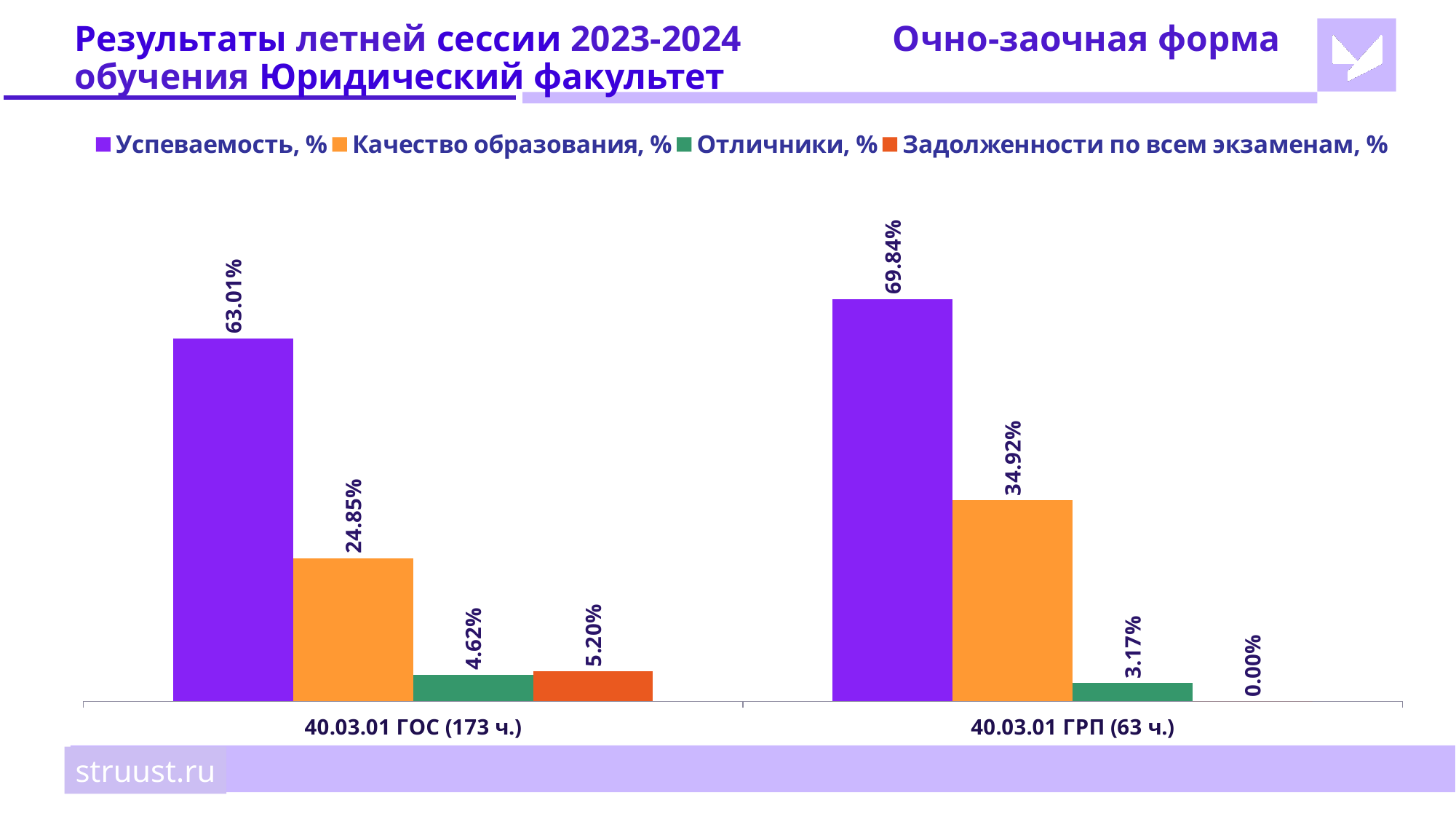
What is the difference in Успеваемость, % between 40.03.01 ГРП (63 ч.) and 40.03.01 ГОС (173 ч.)? 6.83% What is the difference in Качество образования, % between 40.03.01 ГРП (63 ч.) and 40.03.01 ГОС (173 ч.)? 10.07% What is the value of Задолженности по всем экзаменам, % for 40.03.01 ГРП (63 ч.)? 0.00% How many series does the legend list? 4 What is the value of Качество образования, % for 40.03.01 ГРП (63 ч.)? 34.92% What kind of chart is shown on the slide? Bar chart Which category has the lower value for Качество образования, %? 40.03.01 ГОС (173 ч.) Which category has the higher value for Успеваемость, %? 40.03.01 ГРП (63 ч.) What is the value of Успеваемость, % for 40.03.01 ГОС (173 ч.)? 63.01% Which is larger for 40.03.01 ГОС (173 ч.): Отличники, % or Задолженности по всем экзаменам, %? Задолженности по всем экзаменам, % What is the value of Отличники, % for 40.03.01 ГОС (173 ч.)? 4.62% How many categories are shown on the x axis? 2